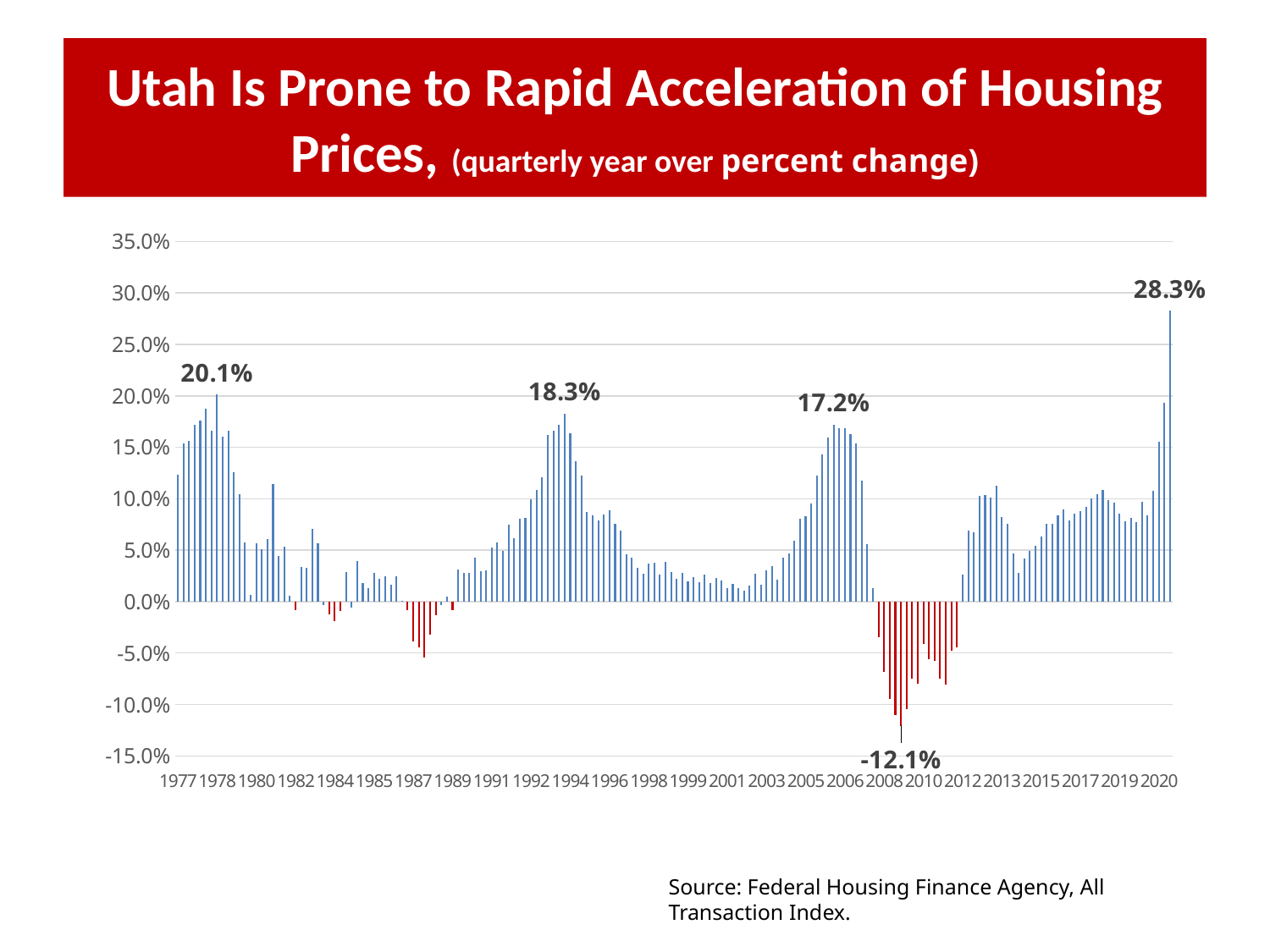
Which labeled peak is larger, the one around 1978 or the one around 1994? The one around 1978 (20.1%) Do the values generally rise or fall from 2012 to 2020? Rise Is the value for the final bar in 2020 greater or less than 25.0%? greater What is the labeled peak value around 2006? 17.2% How much higher is the 28.3% peak than the 20.1% peak? 8.2 percentage points What is the lowest labeled value on the chart? -12.1% What colour are the bars with negative values? Red Are the values around 1987 greater or less than 0.0%? less What kind of chart is shown on the slide? Bar chart What is the highest labeled value on the chart? 28.3% What is the labeled peak value around 1994? 18.3% What is the labeled peak value around 1978? 20.1%